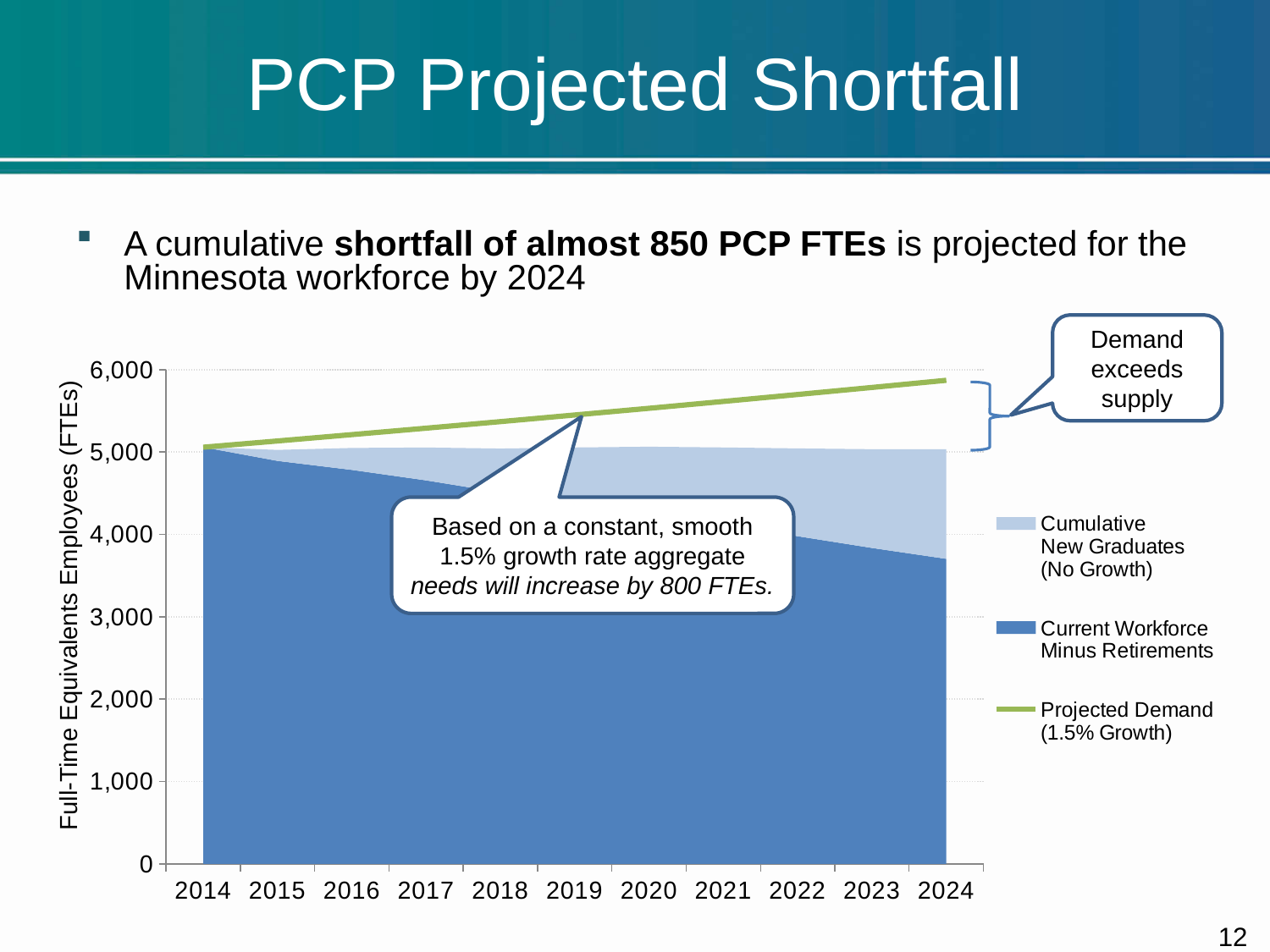
What is the first year shown on the chart's x axis? 2014 What is the label on the chart's y axis? Full-Time Equivalents Employees (FTEs) Does the Projected Demand (1.5% Growth) line rise or fall from 2014 to 2024? rise Is the value of Current Workforce Minus Retirements in 2024 greater or less than 4,000? less What colour is the Projected Demand (1.5% Growth) line in the chart? green What kind of chart is shown on the slide? area and line chart Is the value of Current Workforce Minus Retirements in 2019 greater or less than 4,000? greater Is the value of Projected Demand (1.5% Growth) in 2024 greater or less than 5,000? greater How many years are shown along the x axis of the chart? 11 In 2024, which is larger: Projected Demand (1.5% Growth) or Current Workforce Minus Retirements? Projected Demand (1.5% Growth) Does the Current Workforce Minus Retirements area rise or fall from 2014 to 2024? fall How many series does the chart's legend list? 3